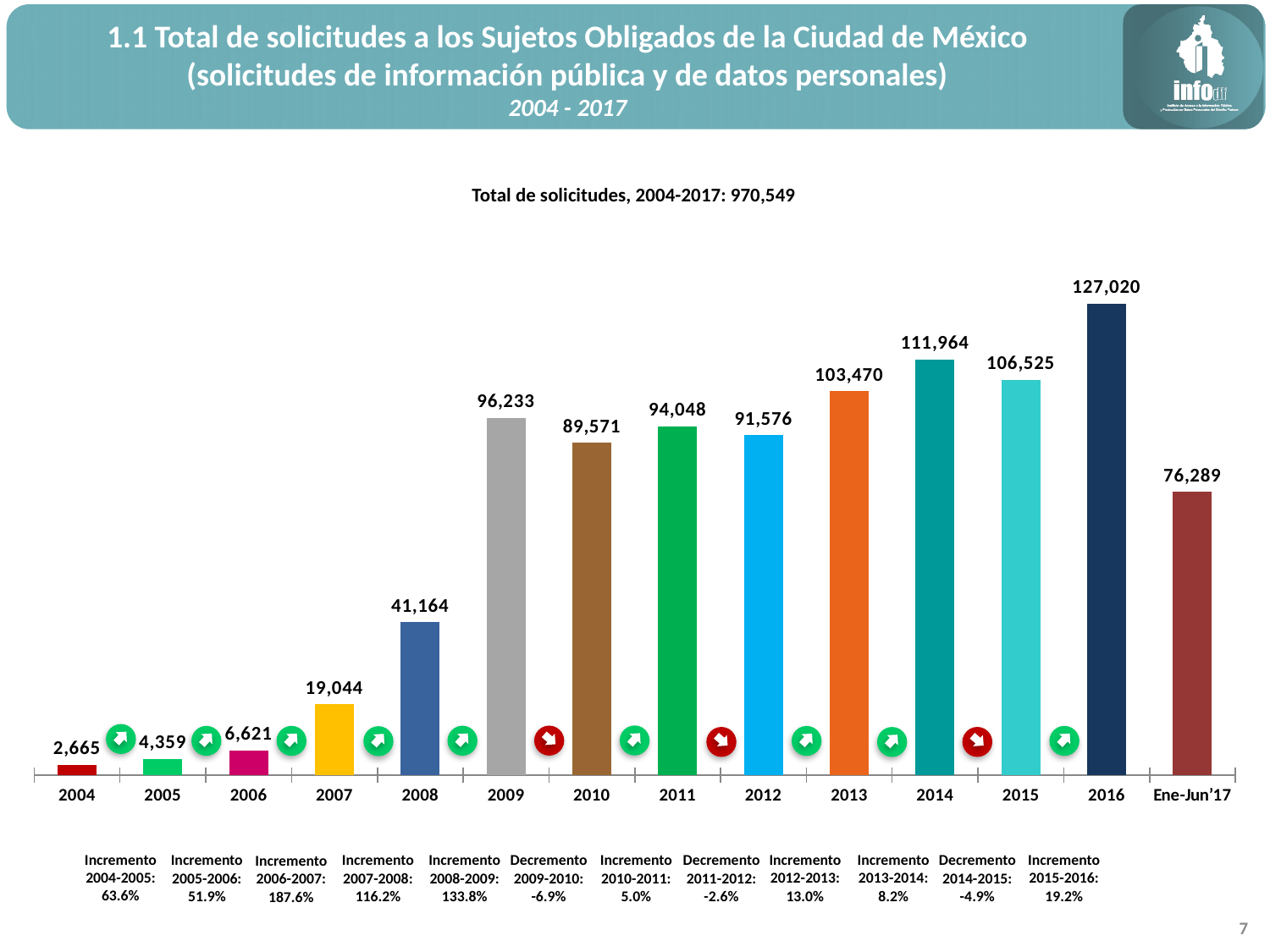
What total of solicitudes for 2004-2017 is stated above the chart? 970,549 What is the value for 2008? 41,164 What kind of chart is shown on the slide? Bar chart Which is larger, the value for 2011 or the value for 2012? 2011 What is the value for 2016? 127,020 Which year has the lowest number of solicitudes? 2004 What is the difference between the values for 2009 and 2008? 55,069 Which year has the highest number of solicitudes? 2016 How many bars are plotted in the chart? 14 What is the value for Ene-Jun'17? 76,289 Do the values rise or fall from 2004 to 2009? Rise What is the difference between the values for 2016 and 2015? 20,495